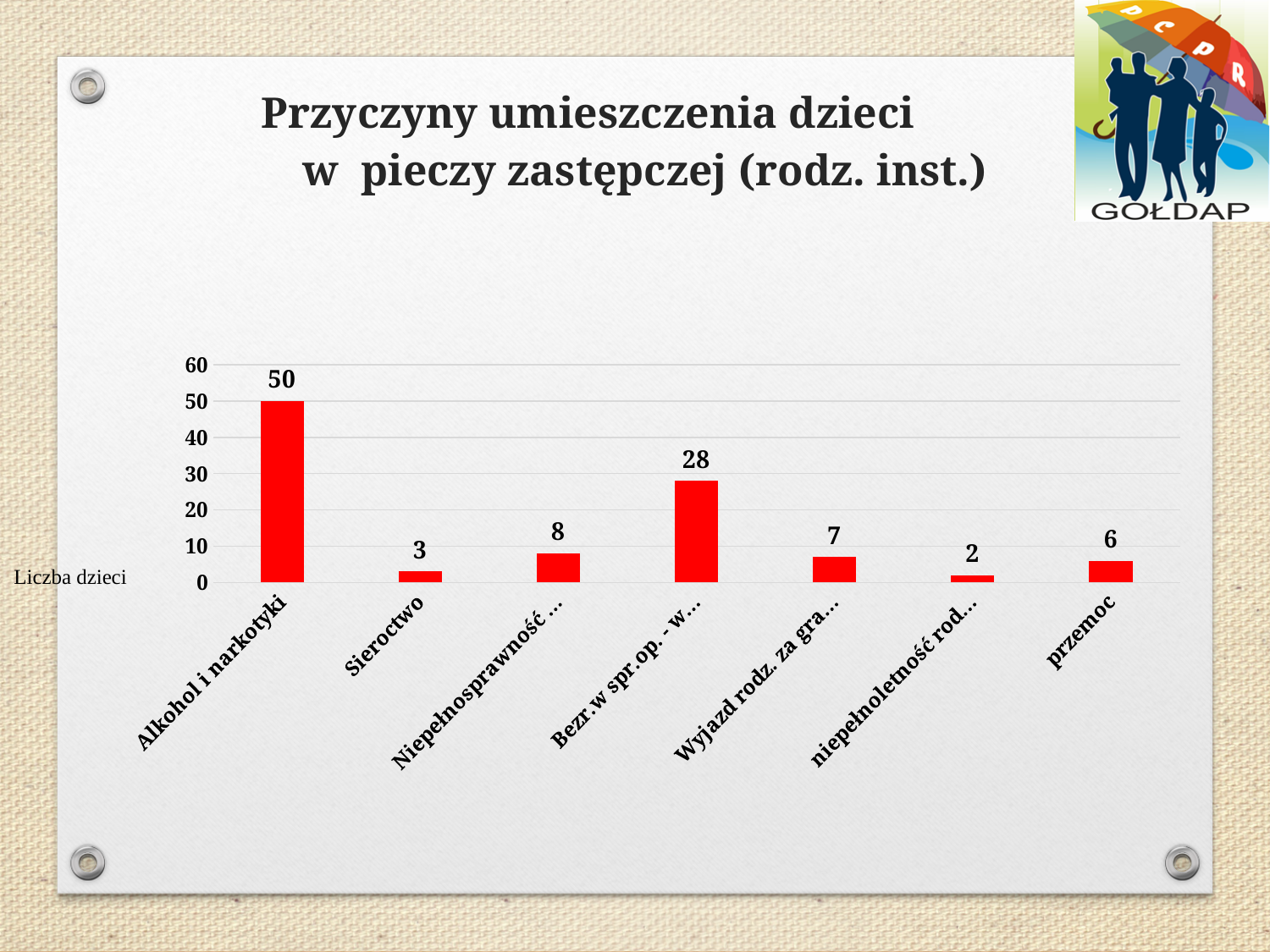
What type of chart is shown on the slide? bar chart What is the value for "Sieroctwo"? 3 What is the value for "Alkohol i narkotyki"? 50 What is the value for the category whose label begins with "Bezr.w spr.op."? 28 Which category has the highest value? Alkohol i narkotyki How many categories are shown on the x axis of the chart? 7 What is the difference between the values for "Alkohol i narkotyki" and the category beginning with "Bezr.w spr.op."? 22 What is the value for the category whose label begins with "Niepełnosprawność"? 8 What is the label shown next to the vertical axis of the chart? Liczba dzieci Which is larger, the value for "Sieroctwo" or the value for "przemoc"? przemoc Which category has the lowest value? niepełnoletność rod... What is the value for "przemoc"? 6